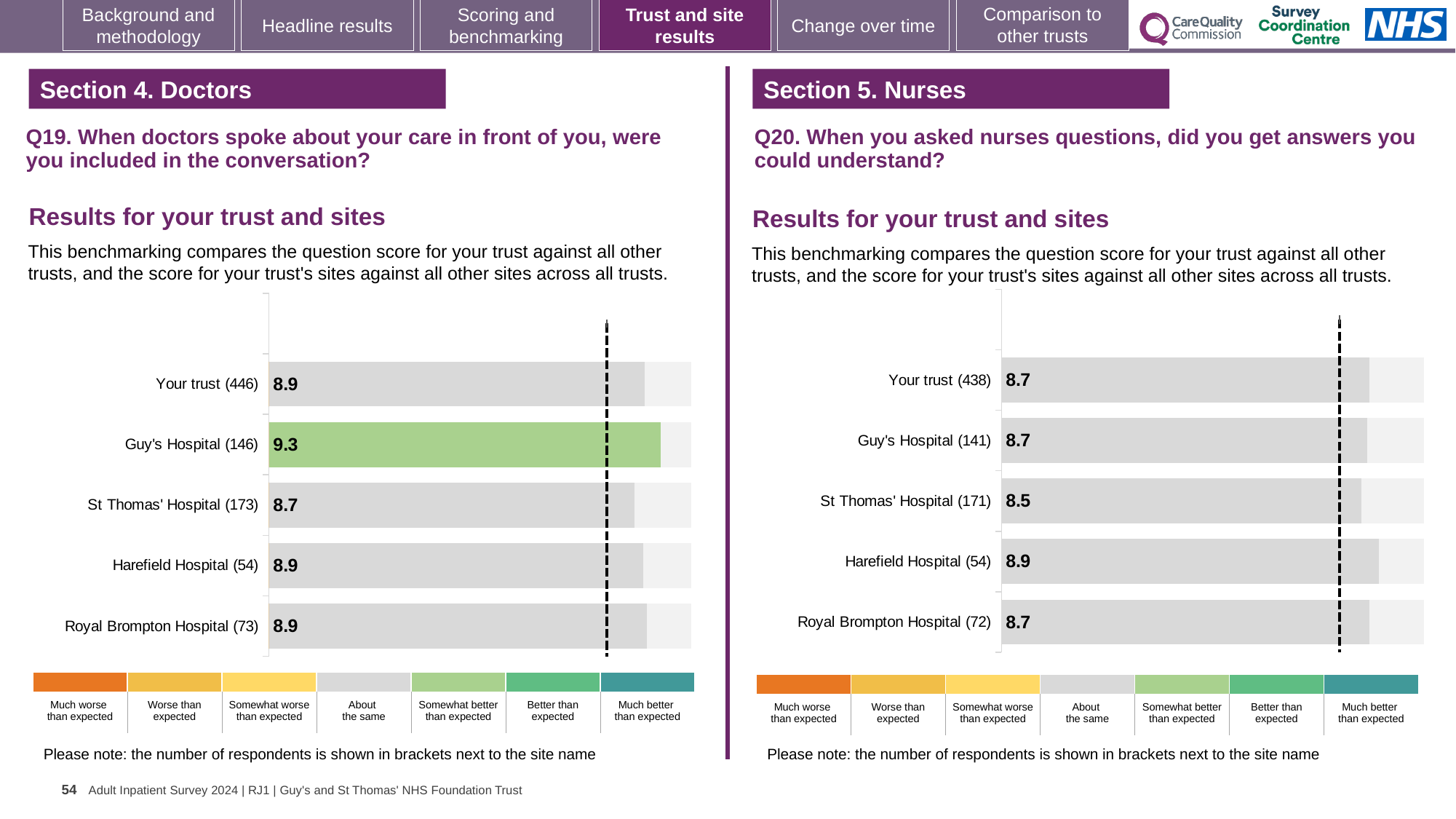
In the Q20 chart on the right, what is the score for Harefield Hospital? 8.9 In the Q19 chart on the left, which site has the lowest score? St Thomas' Hospital In the Q19 chart on the left, what is the score for St Thomas' Hospital? 8.7 In the Q20 chart on the right, what is the score for Your trust? 8.7 What kind of chart is used for the Q20 results on the right? Bar chart In the Q19 chart on the left, which benchmark category does the green colour of the Guy's Hospital bar indicate? Somewhat better than expected In the Q20 chart on the right, which site has the lowest score? St Thomas' Hospital In the Q20 chart on the right, which is larger, the score for Harefield Hospital or the score for St Thomas' Hospital? Harefield Hospital In the Q19 chart on the left, what is the score for Guy's Hospital? 9.3 In the Q19 chart on the left, which site has the highest score? Guy's Hospital In the Q19 chart on the left, how many bars are plotted? 5 In the Q19 chart on the left, what is the difference between the scores for Guy's Hospital and St Thomas' Hospital? 0.6